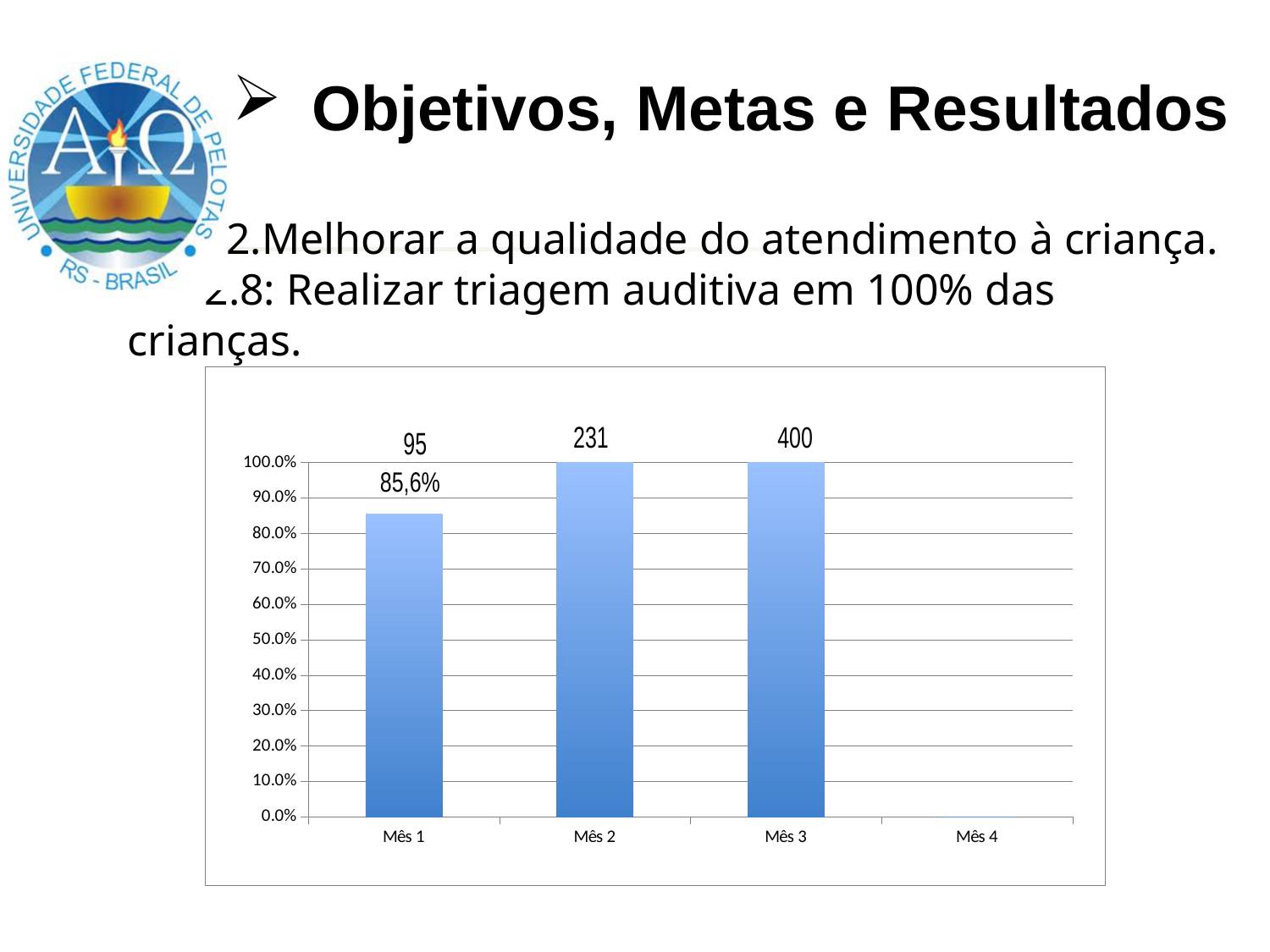
What number is printed above the bar for Mês 2? 231 Do the bar values rise or fall from Mês 1 to Mês 3? rise What number is printed above the bar for Mês 1? 95 What number is printed above the bar for Mês 3? 400 How many categories are shown on the x axis? 4 Is the value for Mês 3 greater or less than 50.0%? greater Which category on the x axis has no bar plotted? Mês 4 Of Mês 1, Mês 2 and Mês 3, which has the lowest bar? Mês 1 Is the value for Mês 1 greater or less than 90.0%? less What kind of chart is shown on the slide? bar chart What value is labelled on the bar for Mês 1? 85,6% Which bar is taller, Mês 1 or Mês 2? Mês 2